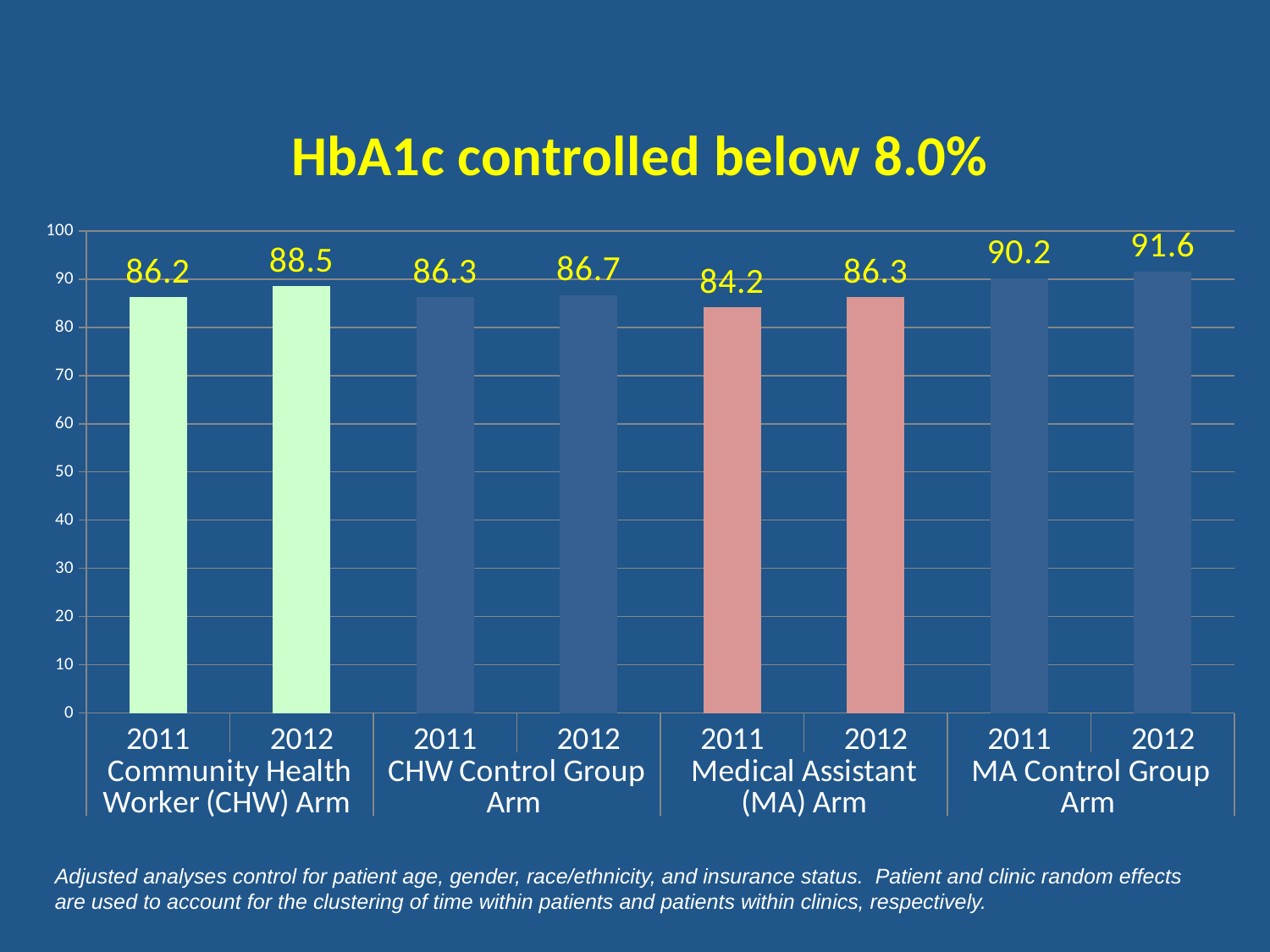
What is the difference between the 2012 and 2011 values in the Medical Assistant (MA) Arm? 2.1 Which is larger: the 2012 value for the CHW Control Group Arm or the 2012 value for the MA Control Group Arm? 2012 MA Control Group Arm How many bars are plotted on the chart? 8 What is the value for 2011 in the CHW Control Group Arm? 86.3 What kind of chart is shown on the slide? Bar chart Which bar has the lowest value on the chart? 2011 Medical Assistant (MA) Arm Which bar has the highest value on the chart? 2012 MA Control Group Arm What is the value for 2012 in the MA Control Group Arm? 91.6 What is the difference between the 2012 and 2011 values in the Community Health Worker (CHW) Arm? 2.3 What is the value for 2011 in the Medical Assistant (MA) Arm? 84.2 What is the title of the chart? HbA1c controlled below 8.0% What is the value for 2012 in the Community Health Worker (CHW) Arm? 88.5